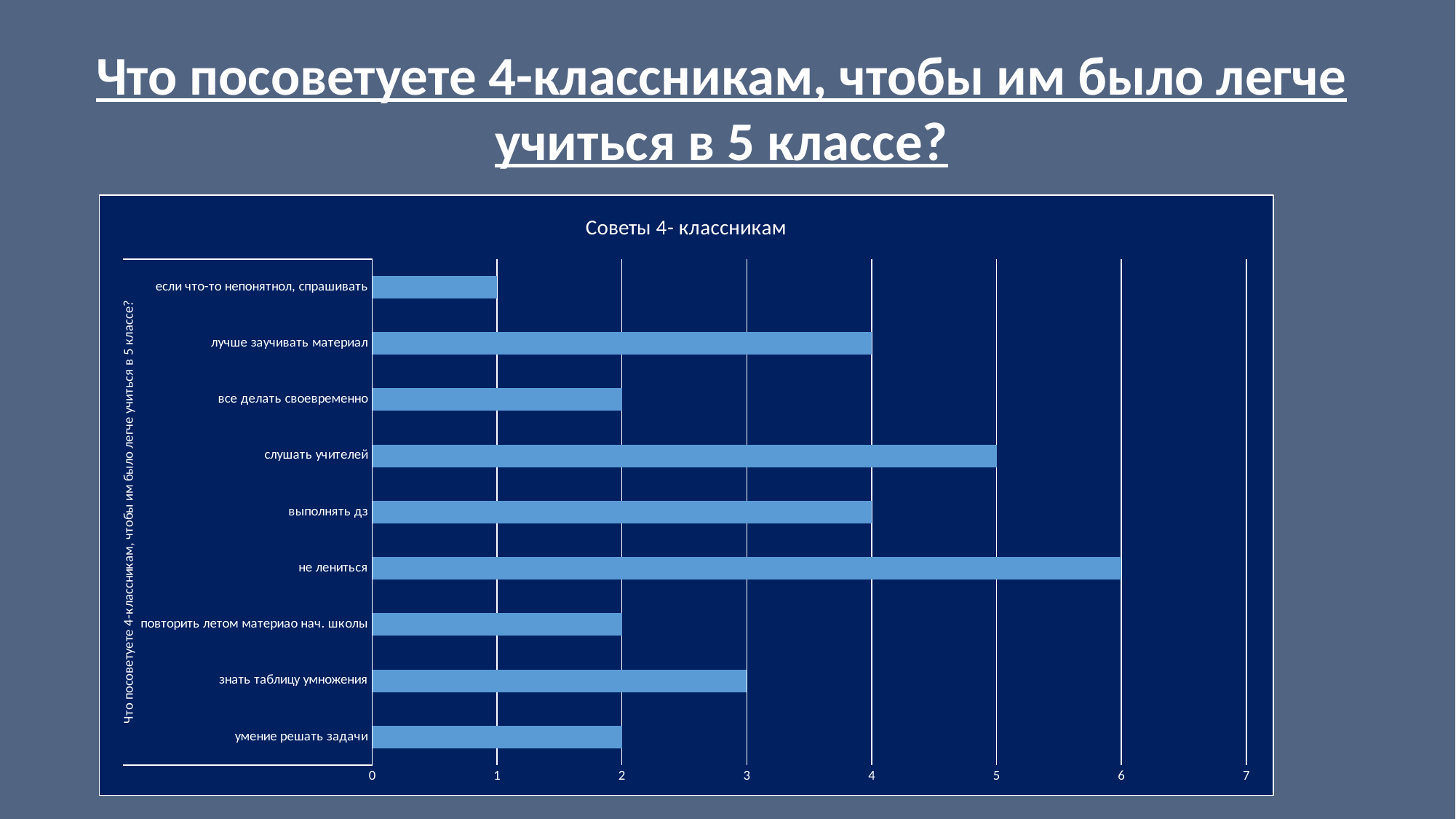
What type of chart is shown on the slide? bar chart What is the value for "если что-то непонятнол, спрашивать"? 1 What is the title of the chart? Советы 4- классникам Is the value for "выполнять дз" greater or less than 3? greater How many categories are plotted in the chart? 9 What is the value for "слушать учителей"? 5 What is the value for "знать таблицу умножения"? 3 What is the difference between the values for "не лениться" and "слушать учителей"? 1 Which is larger, the value for "лучше заучивать материал" or the value for "все делать своевременно"? лучше заучивать материал Which category has the lowest value? если что-то непонятнол, спрашивать Which category has the highest value? не лениться What is the value for "не лениться"? 6